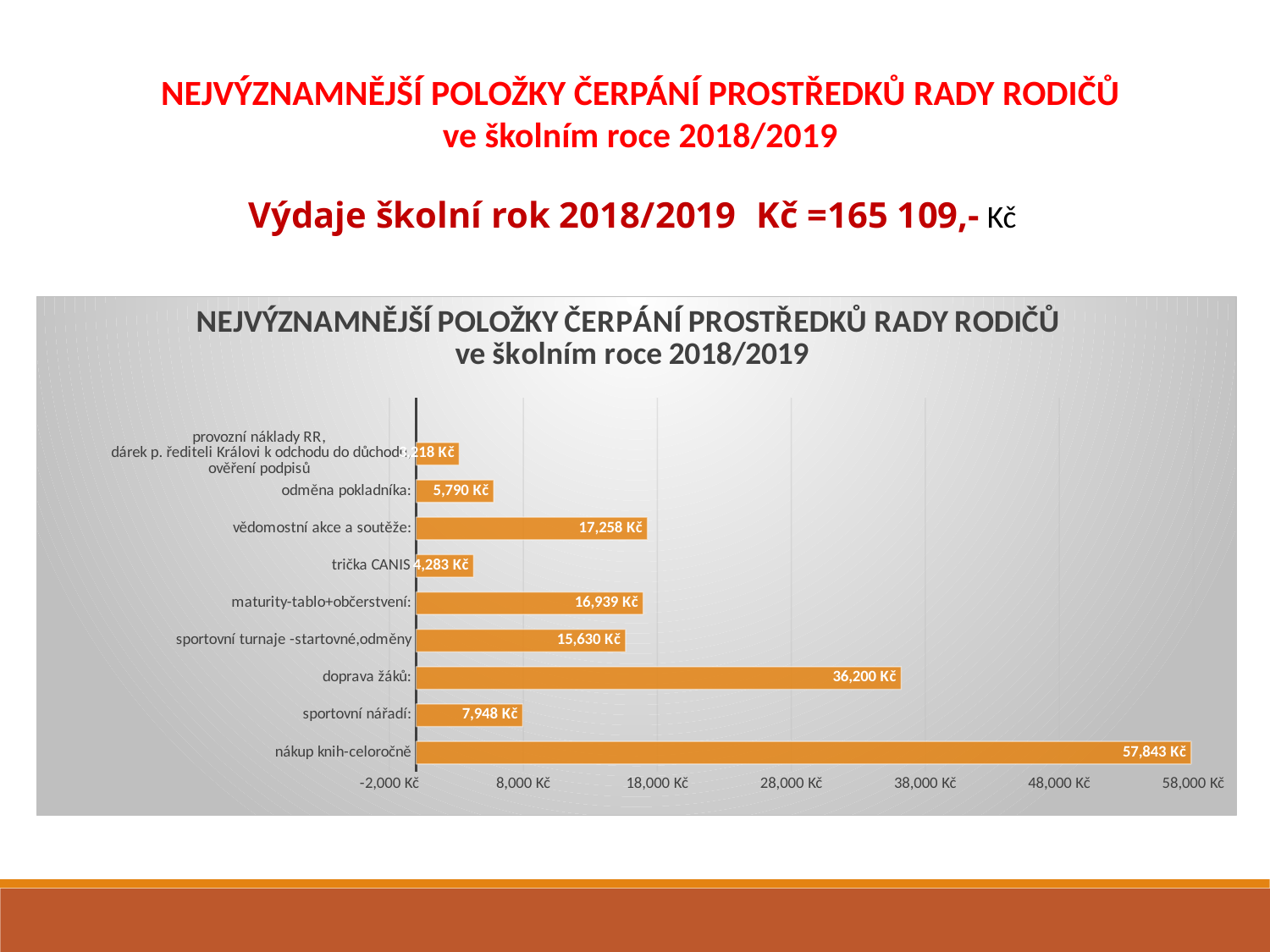
What type of chart is shown on the slide? bar chart What is the difference between 'nákup knih-celoročně' and 'doprava žáků:'? 21,643 Kč What is the value for 'nákup knih-celoročně'? 57,843 Kč Which category has the highest value? nákup knih-celoročně Is the value for 'trička CANIS' greater or less than 8,000 Kč? less Which is larger, 'maturity-tablo+občerstvení:' or 'sportovní turnaje -startovné,odměny'? maturity-tablo+občerstvení: What is the title of the chart? NEJVÝZNAMNĚJŠÍ POLOŽKY ČERPÁNÍ PROSTŘEDKŮ RADY RODIČŮ ve školním roce 2018/2019 What is the value for 'vědomostní akce a soutěže:'? 17,258 Kč What is the value for 'odměna pokladníka:'? 5,790 Kč What is the value for 'sportovní nářadí:'? 7,948 Kč What is the value for 'doprava žáků:'? 36,200 Kč How many categories are plotted in the chart? 9